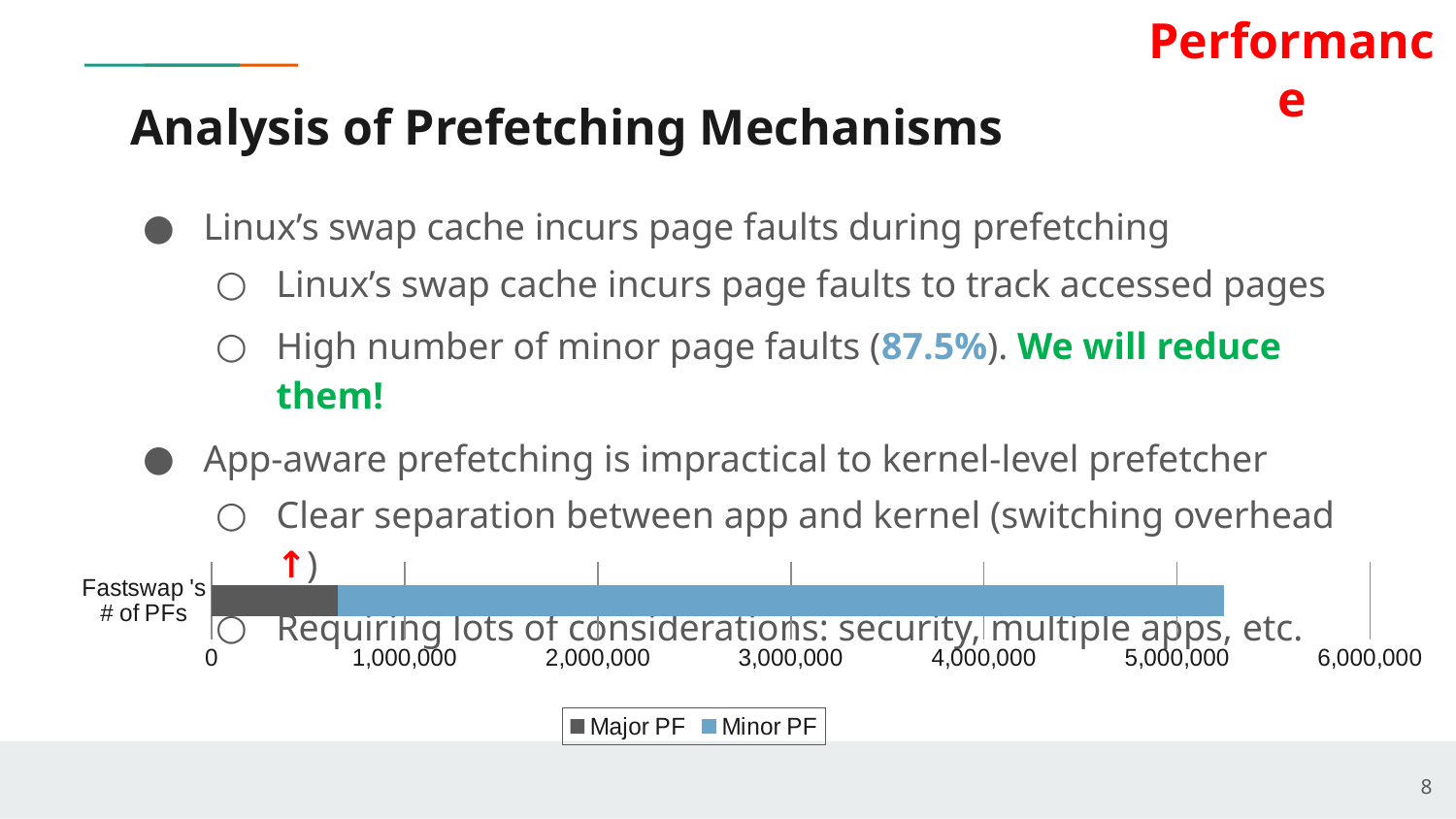
Is the Minor PF segment of the bar greater or less than 3,000,000 in length? greater What is the label of the single category plotted in the chart? Fastswap 's # of PFs Is the total length of the stacked bar for Fastswap's # of PFs greater or less than 5,000,000? greater How many categories (bars) are plotted in the chart? 1 Which series has the larger value in the Fastswap's # of PFs bar, Major PF or Minor PF? Minor PF Is the Major PF value for Fastswap's # of PFs greater or less than 1,000,000? less How many series does the chart's legend list? 2 What is the highest tick value shown on the chart's horizontal axis? 6,000,000 What are the two series named in the chart's legend? Major PF and Minor PF What kind of chart is shown at the bottom of the slide? bar chart